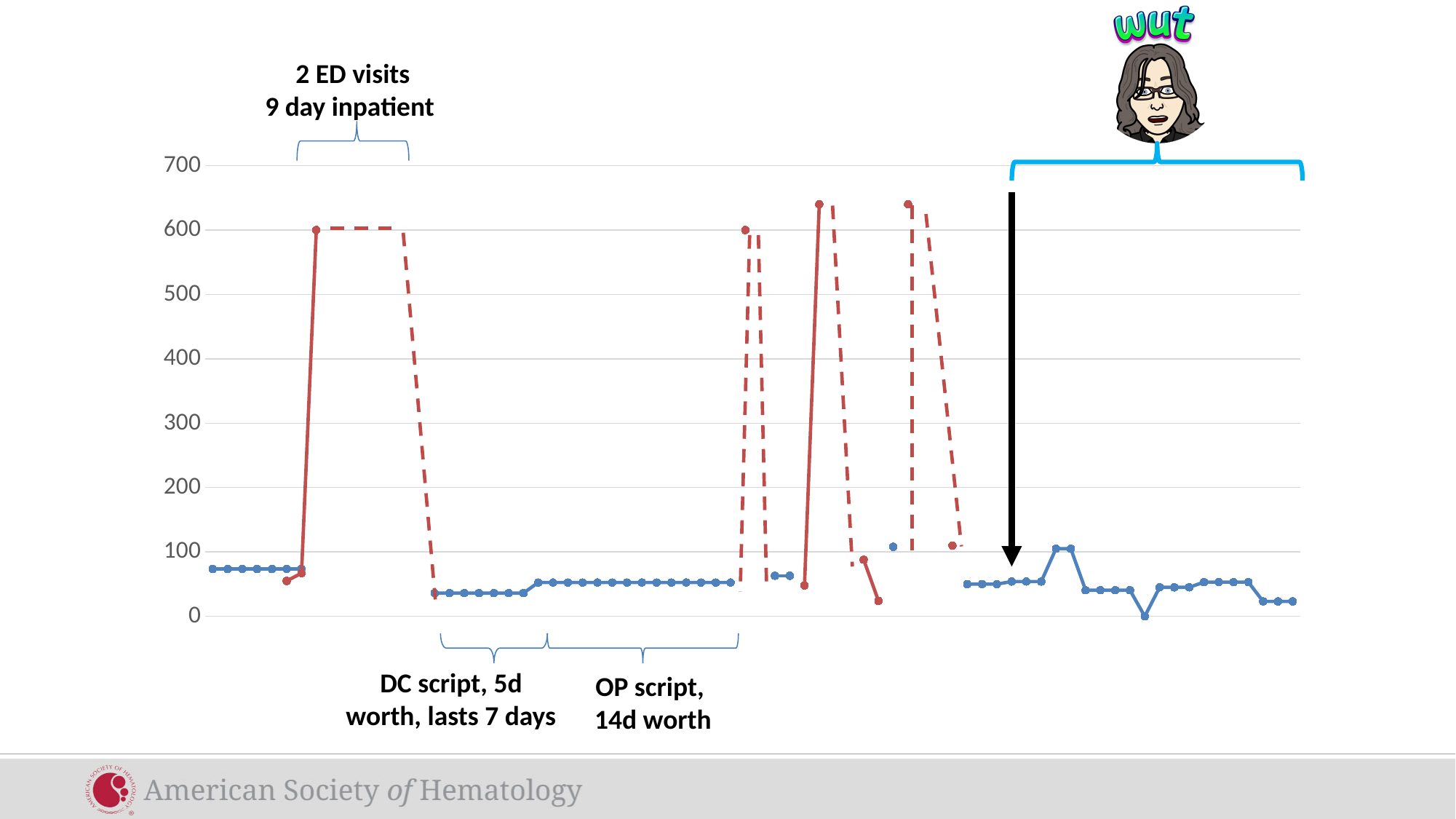
How many tick labels are shown on the y axis? 8 Is the value of the first red plateau, under the '2 ED visits' bracket, greater or less than 500? greater What kind of chart is shown on the slide? line chart Are the blue line values during the 'OP script, 14d worth' period greater or less than 100? less Is the lowest blue point in the right-hand section of the chart greater or less than 50? less Do the blue values rise or fall over the last few points at the far right of the chart? fall What annotation appears above the first red plateau? 2 ED visits 9 day inpatient Which series reaches higher values, the red line or the blue line? the red line What is the highest value labelled on the y axis? 700